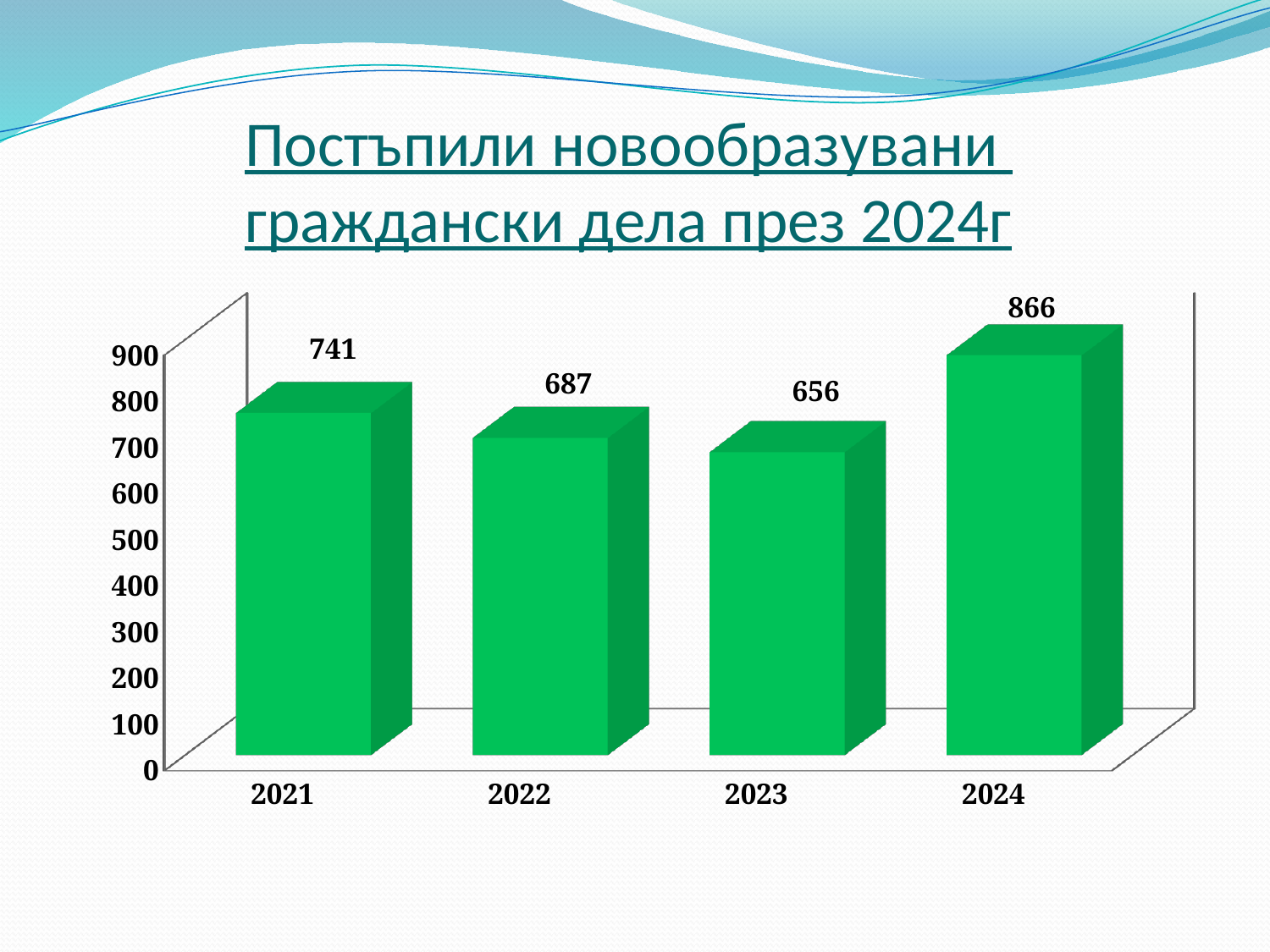
What is the value for 2024? 866 Which is larger, the value for 2021 or the value for 2022? 2021 How many years are shown on the chart? 4 What is the value for 2021? 741 What is the difference between the values for 2021 and 2022? 54 What is the value for 2022? 687 What is the difference between the values for 2024 and 2023? 210 Which year has the lowest value? 2023 What is the value for 2023? 656 What kind of chart is shown on the slide? Bar chart Which year has the highest value? 2024 What is the title of the chart on the slide? Постъпили новообразувани граждански дела през 2024г